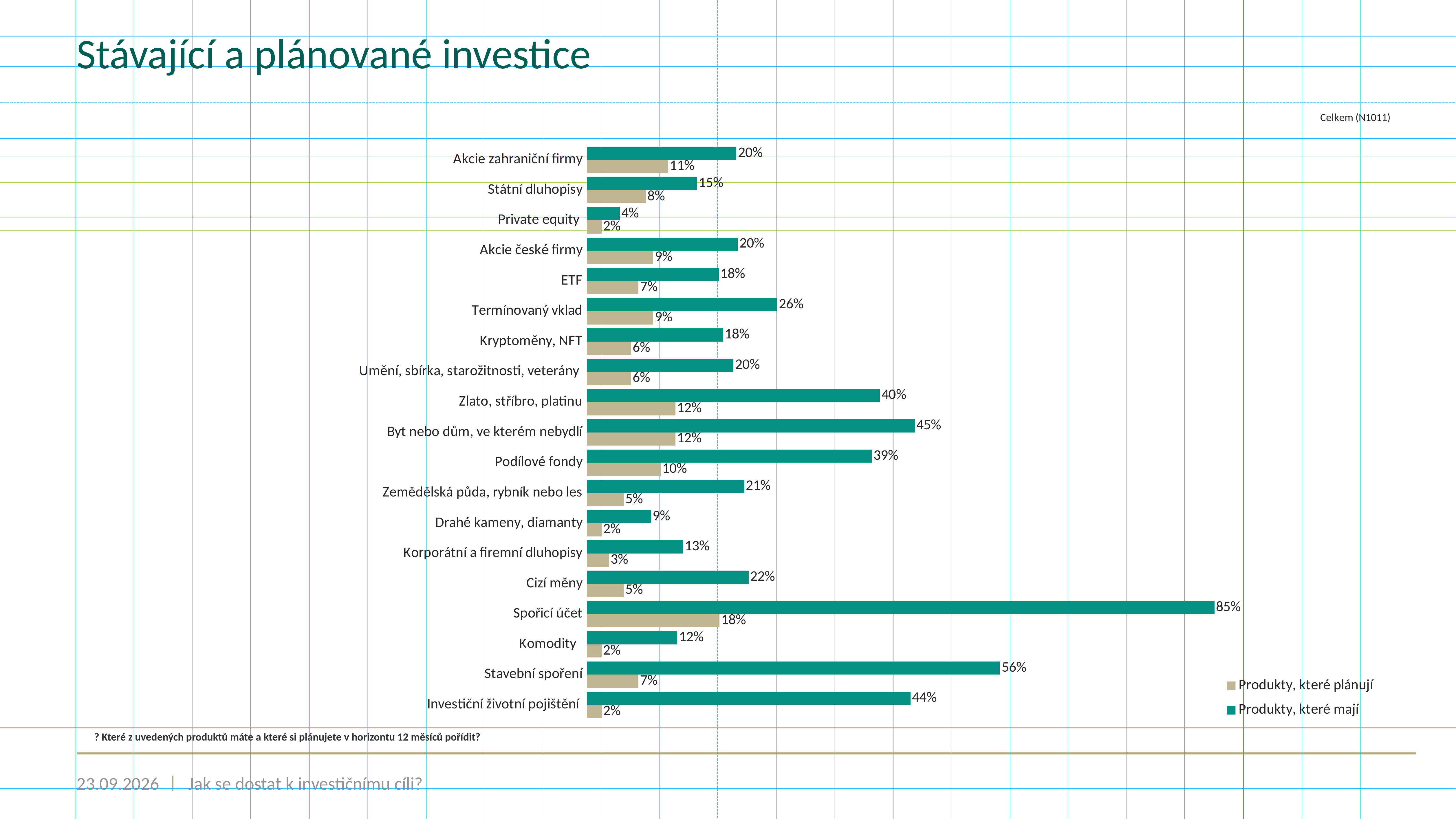
What is the value for Termínovaný vklad in the 'Produkty, které mají' series? 26% How many categories are shown on the chart? 19 What kind of chart is shown on the slide? Bar chart What is the difference between the 'Produkty, které mají' and 'Produkty, které plánují' values for Stavební spoření? 49% Which category has the highest value in the 'Produkty, které mají' series? Spořicí účet What is the value for Investiční životní pojištění in the 'Produkty, které plánují' series? 2% What is the value for Zlato, stříbro, platinu in the 'Produkty, které plánují' series? 12% How many series does the legend list? 2 What percentage of respondents have a Spořicí účet (series 'Produkty, které mají')? 85% Which category has the lowest value in the 'Produkty, které mají' series? Private equity Which is larger in the 'Produkty, které mají' series: Byt nebo dům, ve kterém nebydlí or Podílové fondy? Byt nebo dům, ve kterém nebydlí Which series is shown in teal (dark green) on the chart? Produkty, které mají